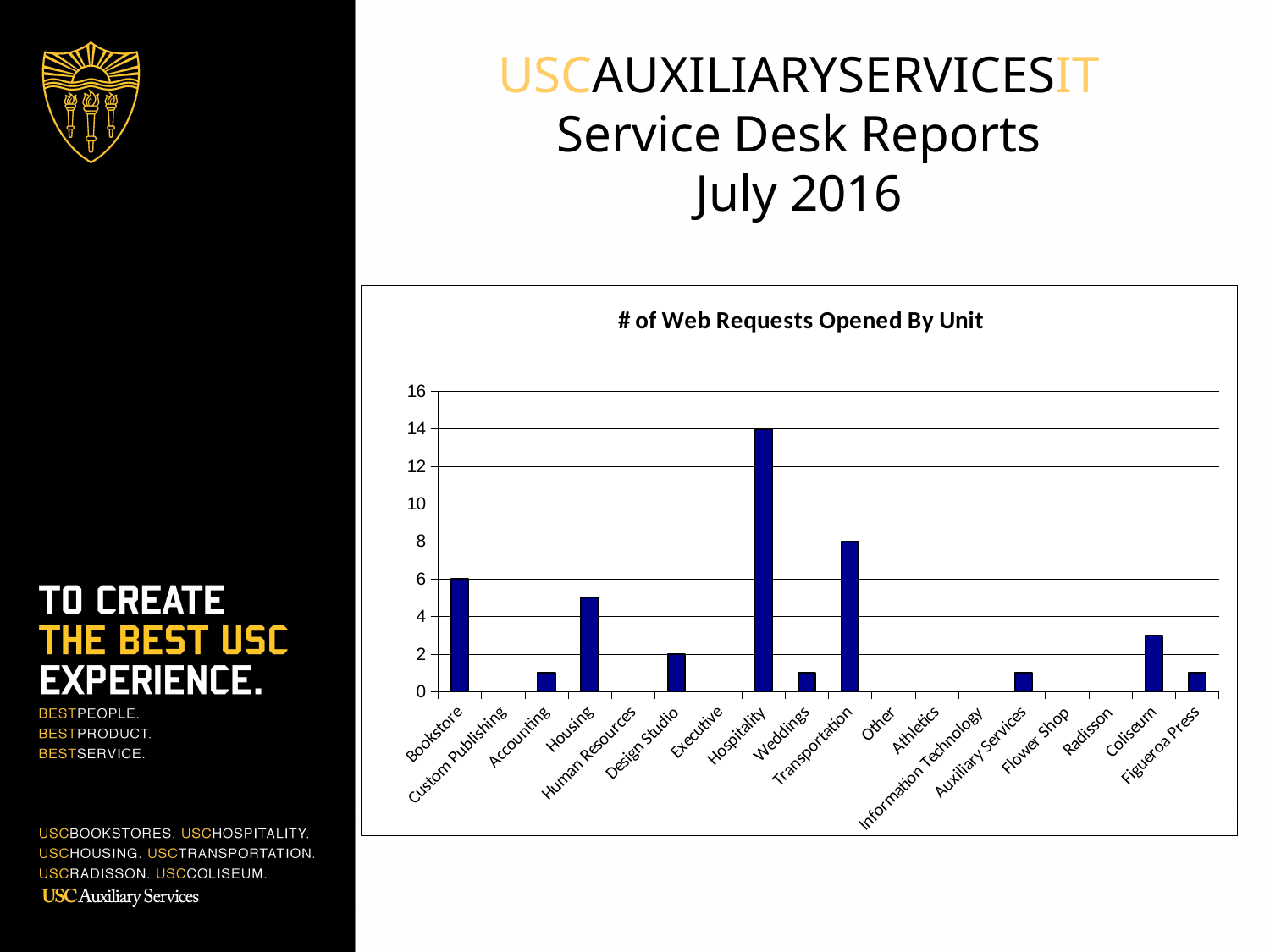
How many web requests were opened by Hospitality? 14 Is the value for Coliseum greater or less than 4? less Is the value for Housing greater or less than 4? greater How many web requests were opened by Transportation? 8 Which has more web requests opened, Bookstore or Housing? Bookstore Which unit has the highest number of web requests opened? Hospitality What kind of chart is shown on the slide? bar chart How many web requests were opened by Bookstore? 6 What is the title of the chart? # of Web Requests Opened By Unit How many web requests were opened by Design Studio? 2 What is the difference between the number of web requests for Hospitality and Transportation? 6 How many units are listed on the x axis of the chart? 18